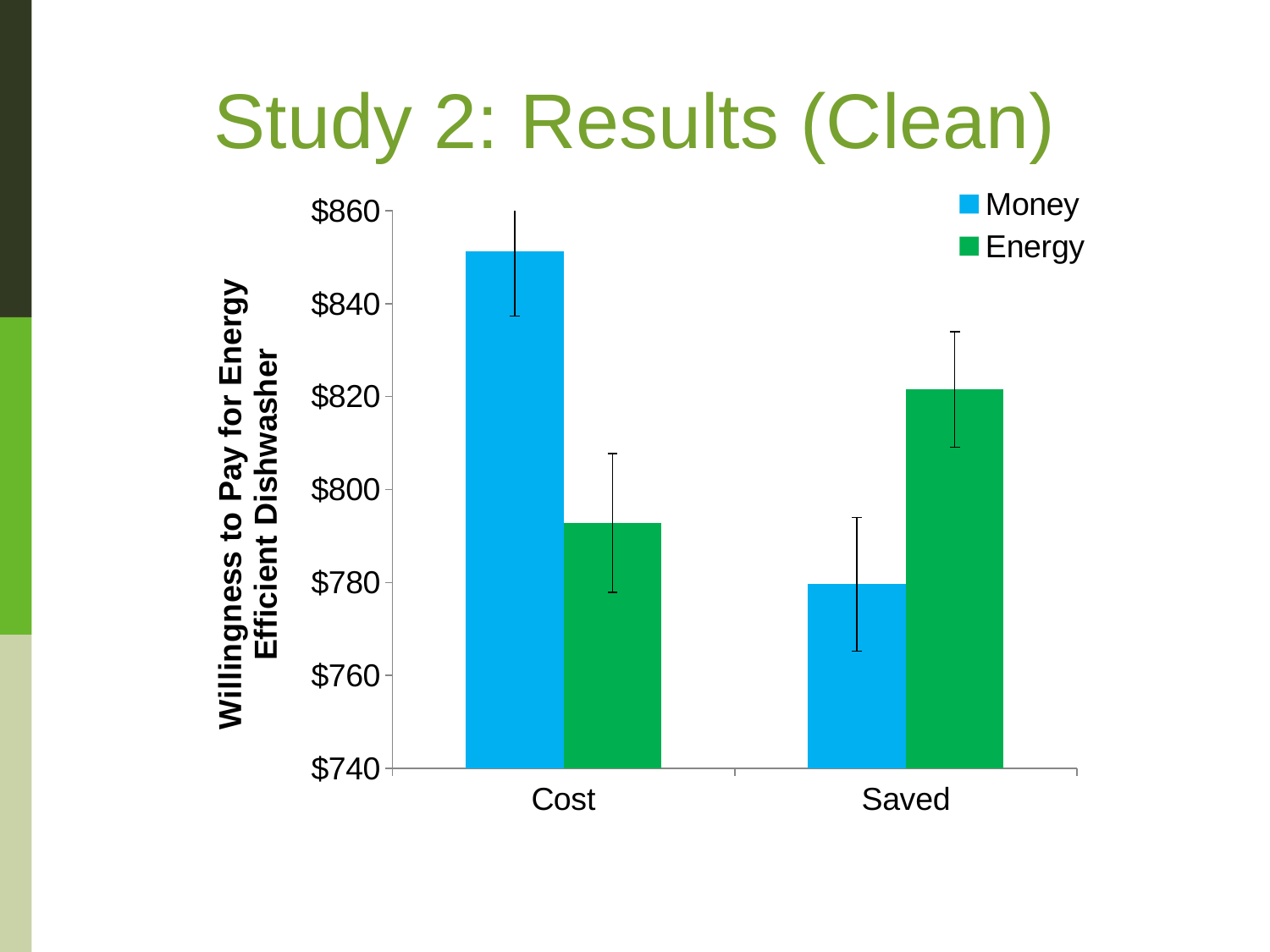
How many series does the legend list? 2 For the Saved category, which series has the larger value, Money or Energy? Energy Is the value for Money in the Cost category greater or less than $840? greater Which colour represents the Energy series in the legend? green For the Cost category, which series has the larger value, Money or Energy? Money What kind of chart is shown on the slide? bar chart Is the value for Energy in the Cost category greater or less than $800? less Is the value for Energy in the Saved category greater or less than $800? greater How many categories are shown on the x axis? 2 Which bar is the highest in the chart? Money for Cost Which bar is the lowest in the chart? Money for Saved What is the title of the y axis? Willingness to Pay for Energy Efficient Dishwasher